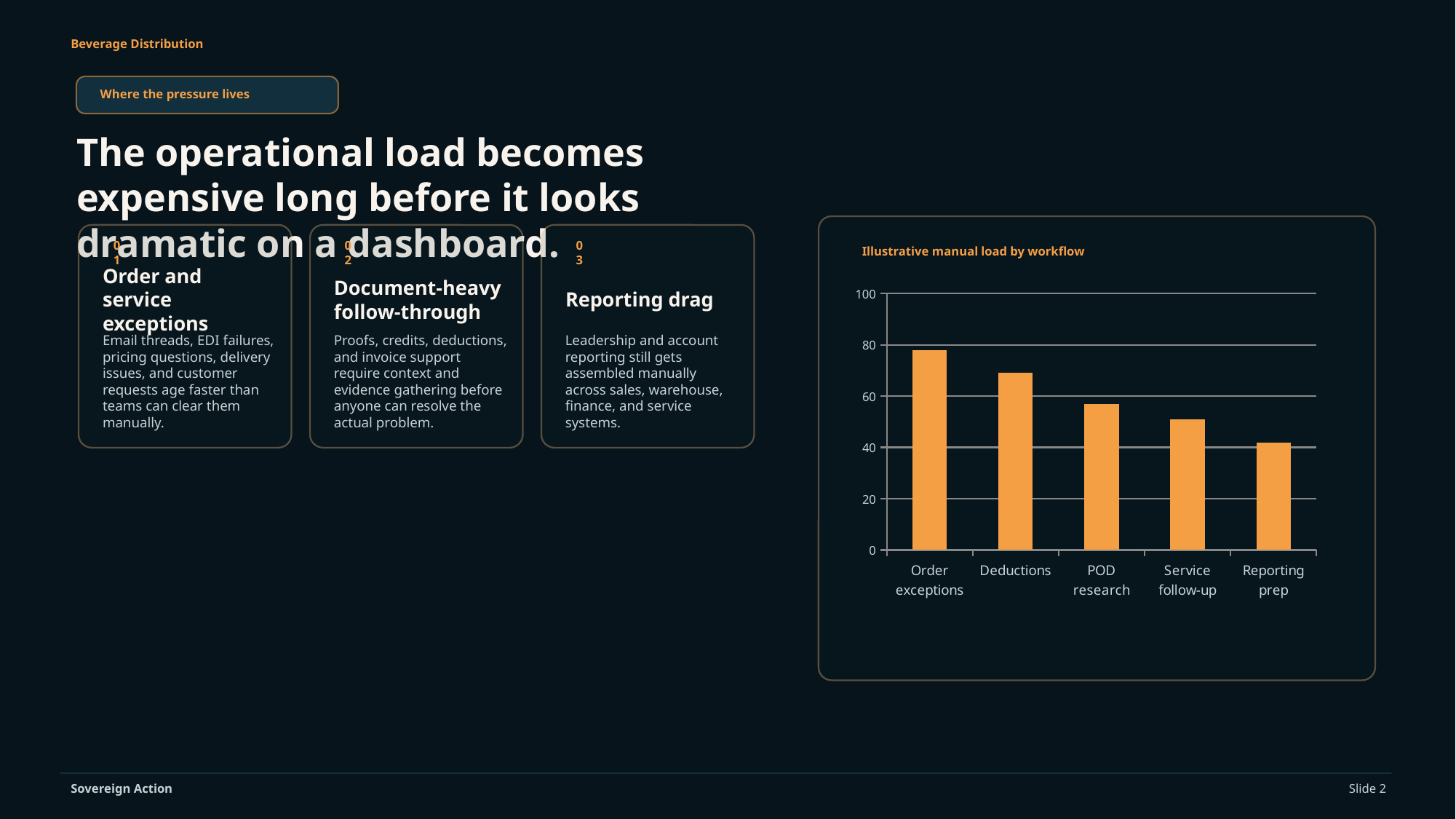
How many workflow categories are plotted in the chart? 5 What is the highest value shown on the chart's vertical axis? 100 Which workflow has the lowest manual load in the chart? Reporting prep Do the values rise or fall moving from left to right across the categories? Fall What kind of chart is shown on the slide? Bar chart Which has a higher value, Service follow-up or Reporting prep? Service follow-up Which workflow has the highest manual load in the chart? Order exceptions Which has a higher value, Deductions or POD research? Deductions Is the value for Deductions greater or less than 80? less Is the value for Order exceptions greater or less than 60? greater What is the title of the chart? Illustrative manual load by workflow Is the value for Reporting prep greater or less than 60? less